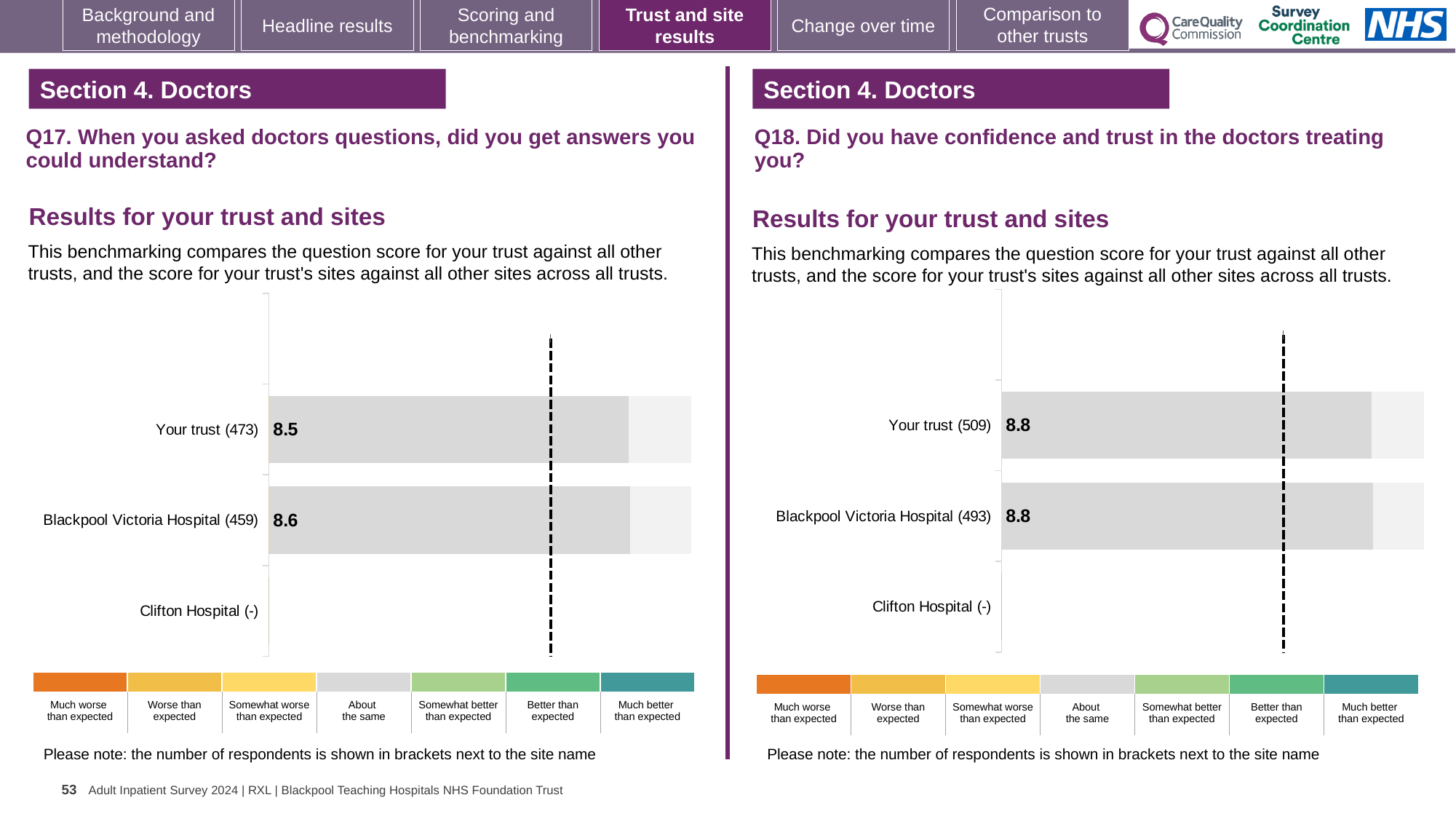
In the Q17 chart on the left, which of the two plotted categories has the lowest score? Your trust (473) In the Q18 chart on the right, how many respondents are shown in brackets for Your trust? 509 In the Q18 chart on the right, what is the score for Blackpool Victoria Hospital (493)? 8.8 In the Q17 chart on the left, which category has no score shown? Clifton Hospital (-) In the Q17 chart on the left, what is the difference between the Blackpool Victoria Hospital score and the Your trust score? 0.1 In the Q17 chart on the left, which is higher: the score for Your trust or for Blackpool Victoria Hospital? Blackpool Victoria Hospital In the Q18 chart on the right, what is the difference between the Your trust score and the Blackpool Victoria Hospital score? 0 In the Q17 chart on the left, what is the score for Blackpool Victoria Hospital (459)? 8.6 In the Q17 chart on the left, what is the score for Your trust (473)? 8.5 How many site/trust categories are listed on the y axis of the Q17 chart on the left? 3 In the Q18 chart on the right, what is the score for Your trust (509)? 8.8 What type of chart is used for the Q18 results on the right? Bar chart